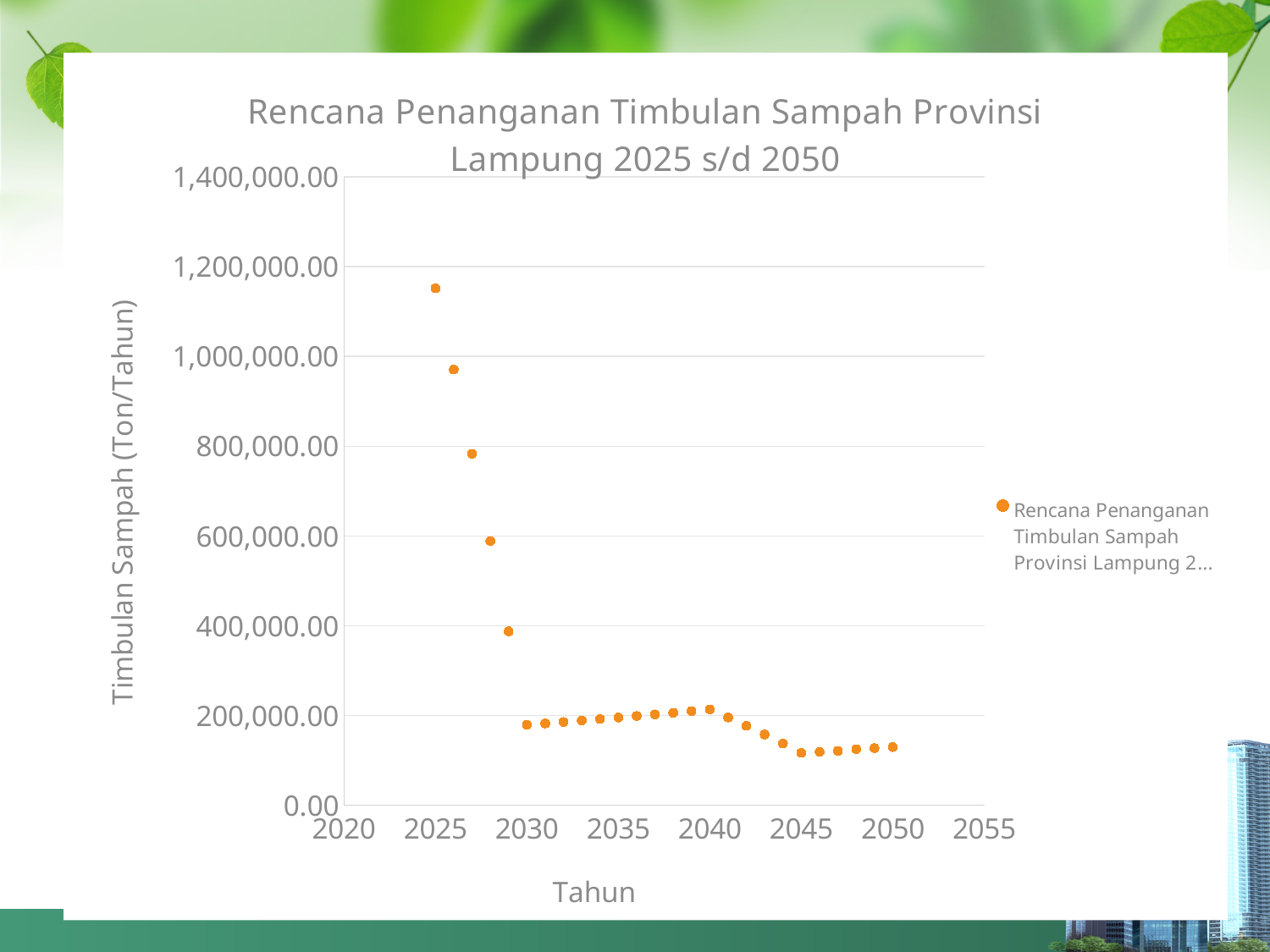
What is the label of the horizontal axis? Tahun Is the value for 2045 greater or less than 200,000.00? less Is the value for 2025 greater or less than 1,000,000.00? greater Which year has the highest value in the chart? 2025 Is the value for 2027 greater or less than 600,000.00? greater What is the label of the vertical axis? Timbulan Sampah (Ton/Tahun) What kind of chart is shown on the slide? Scatter chart Which is larger, the value for 2025 or the value for 2030? 2025 How many series does the legend list? 1 Do the values rise or fall from 2025 to 2030? fall